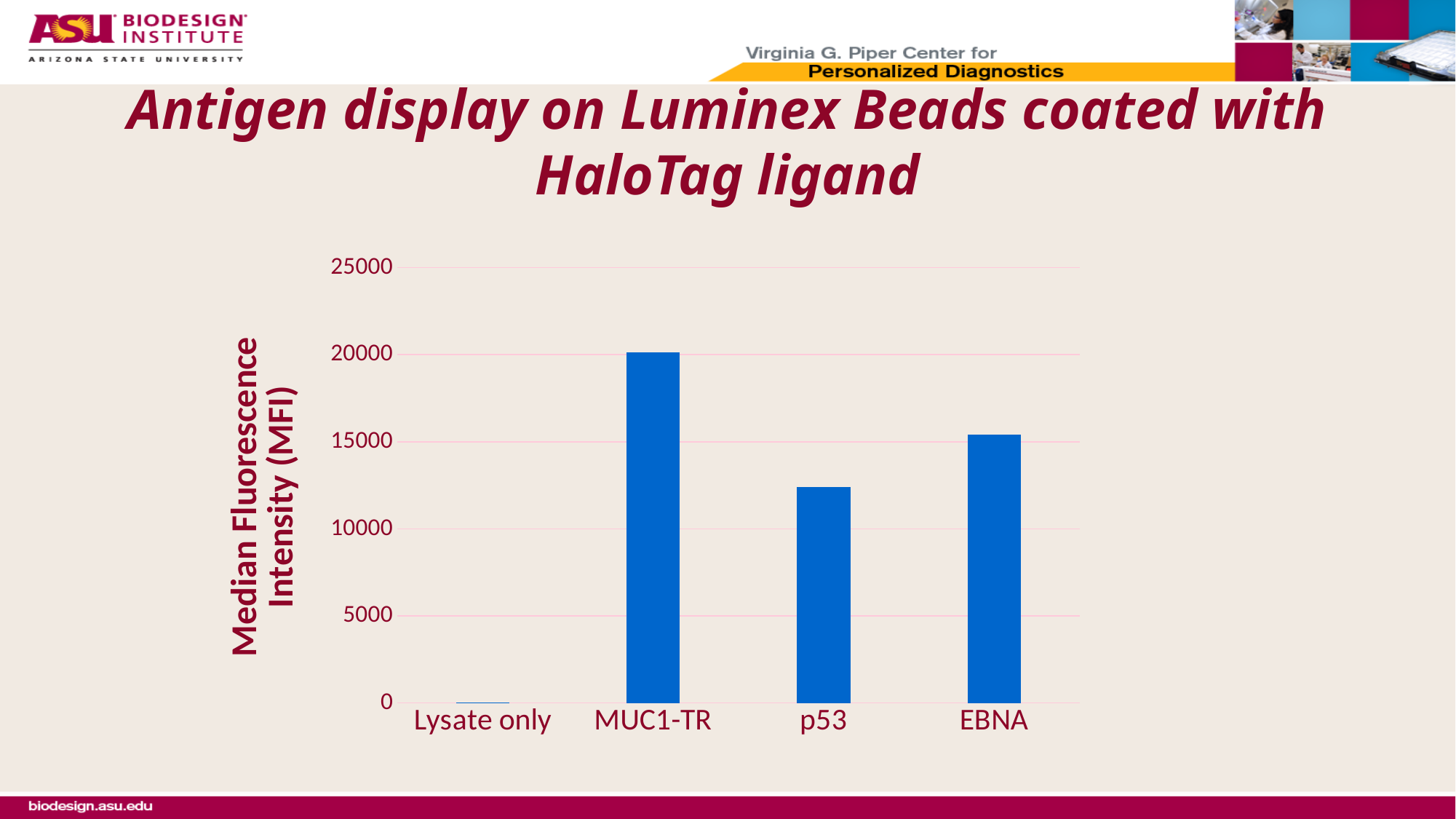
What kind of chart is shown on the slide? bar chart Is the value for p53 greater or less than 15000? less Which category has the lowest Median Fluorescence Intensity? Lysate only Which category has the highest Median Fluorescence Intensity? MUC1-TR Is the value for Lysate only greater or less than 5000? less What is the label of the y axis of the chart? Median Fluorescence Intensity (MFI) Which has a higher Median Fluorescence Intensity, p53 or EBNA? EBNA Which has a higher Median Fluorescence Intensity, MUC1-TR or p53? MUC1-TR What is the highest value shown on the y axis of the chart? 25000 Is the value for EBNA greater or less than 10000? greater How many categories are shown on the x axis of the chart? 4